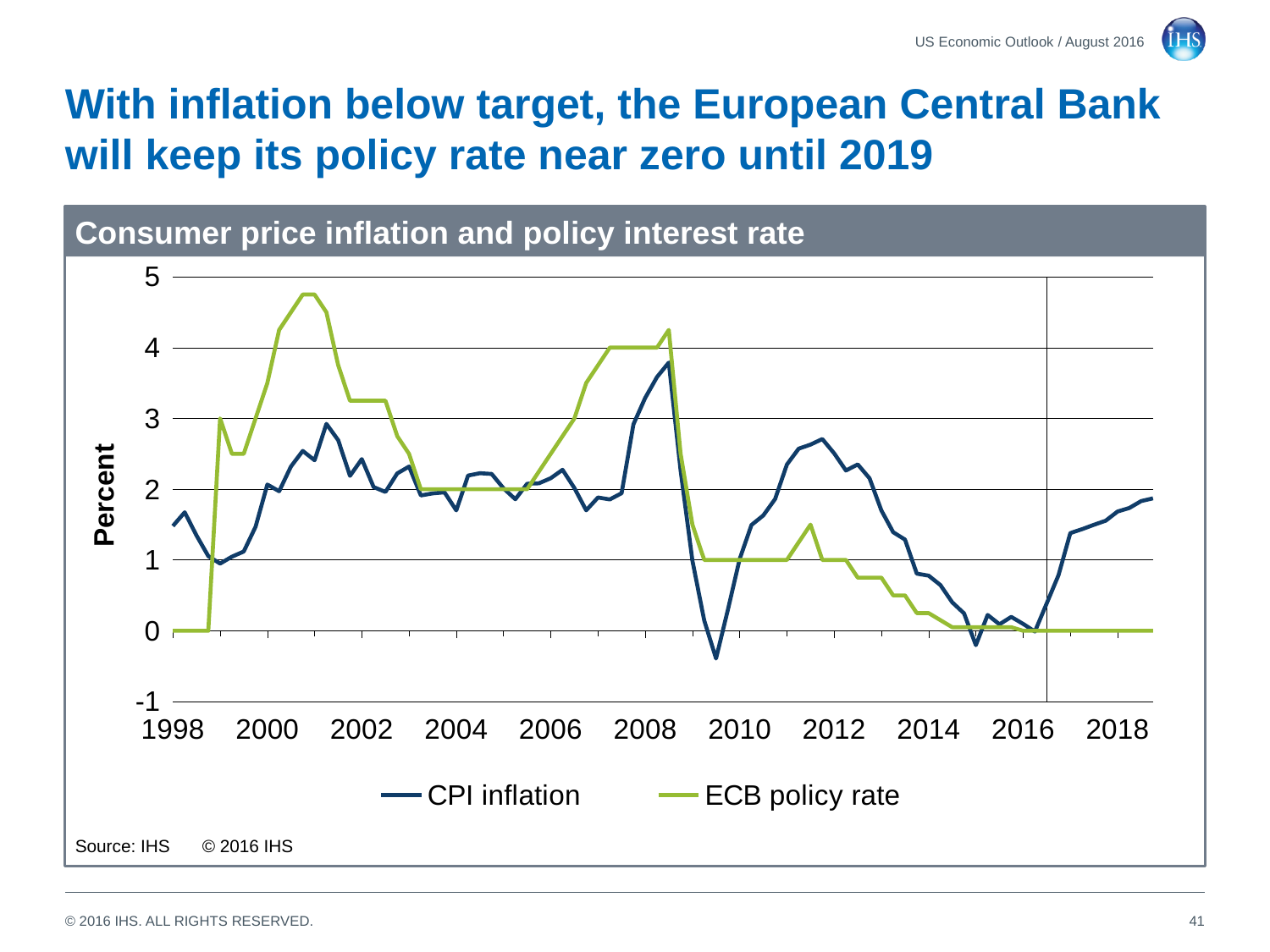
How many series does the legend list? 2 In 2001, which series is higher, CPI inflation or ECB policy rate? ECB policy rate What is the label on the vertical axis? Percent Does the ECB policy rate rise or fall between 2012 and 2016? fall Is the ECB policy rate in 2010 greater or less than 2? less In 2012, which series is higher, CPI inflation or ECB policy rate? CPI inflation What is the title of the chart? Consumer price inflation and policy interest rate Does CPI inflation rise or fall between 2016 and 2018? rise Is the ECB policy rate in 2018 greater or less than 1? less Is the ECB policy rate in 2001 greater or less than 4? greater What kind of chart is shown on the slide? line chart